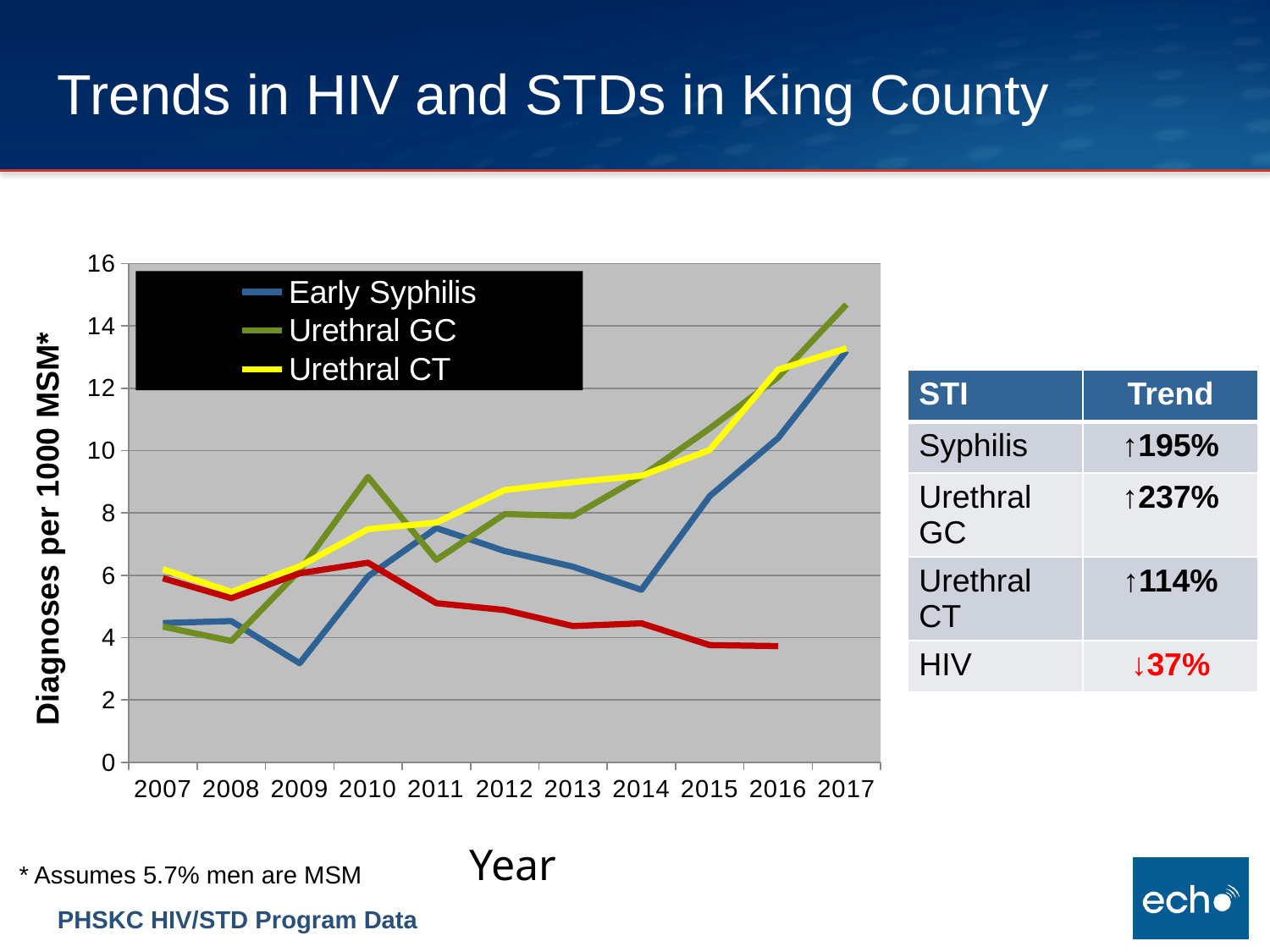
What kind of chart is shown on the slide? line chart In 2017, which is higher: Urethral GC or Early Syphilis? Urethral GC How many series does the chart's legend list? 3 In 2010, which is higher: Urethral GC or Early Syphilis? Urethral GC Is the value for Urethral GC in 2017 greater or less than 14? greater Is the value for Early Syphilis in 2009 greater or less than 4? less Is the value for Urethral GC in 2010 greater or less than 8? greater Does the Urethral CT line rise or fall from 2012 to 2017? rise How many years are shown along the x axis of the chart? 11 Which series has the highest value in 2017? Urethral GC What is the label on the y axis of the chart? Diagnoses per 1000 MSM*